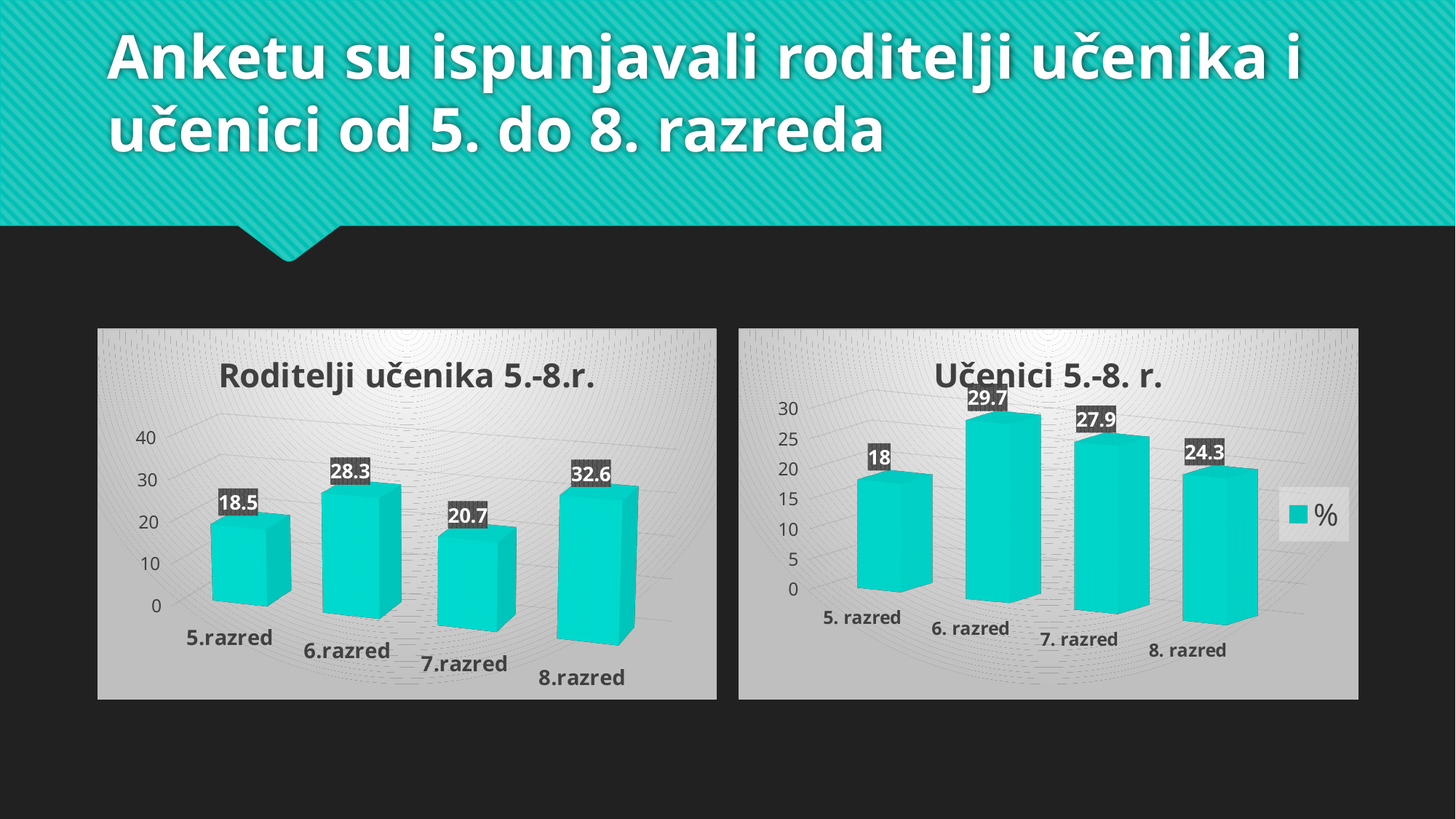
In the chart titled "Roditelji učenika 5.-8.r.", what is the value for 6.razred? 28.3 What kind of chart is the chart titled "Učenici 5.-8. r."? Bar chart In the chart titled "Učenici 5.-8. r.", which category has the lowest value? 5. razred In the chart titled "Roditelji učenika 5.-8.r.", which category has the lowest value? 5.razred In the chart titled "Učenici 5.-8. r.", which is larger: the value for 6. razred or the value for 7. razred? 6. razred How many series does the legend list in the chart titled "Učenici 5.-8. r."? 1 In the chart titled "Učenici 5.-8. r.", what is the difference between the values for 6. razred and 8. razred? 5.4 In the chart titled "Roditelji učenika 5.-8.r.", what is the difference between the values for 8.razred and 5.razred? 14.1 How many categories are shown in the chart titled "Roditelji učenika 5.-8.r."? 4 In the chart titled "Učenici 5.-8. r.", what is the value for 7. razred? 27.9 In the chart titled "Roditelji učenika 5.-8.r.", which category has the highest value? 8.razred What is the legend entry shown in the chart titled "Učenici 5.-8. r."? %